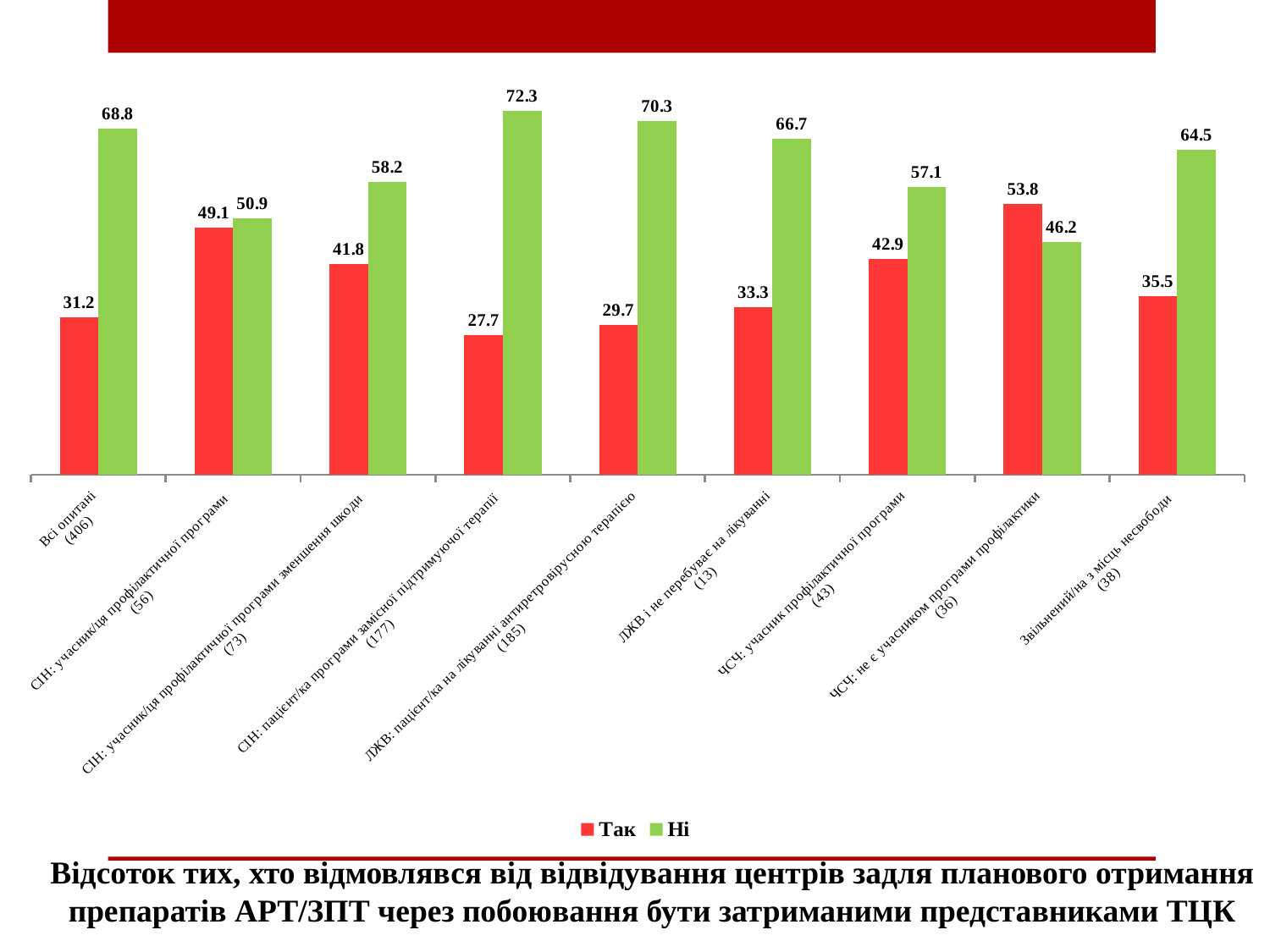
Which category has the lowest value in the "Так" series? СІН: пацієнт/ка програми замісної підтримуючої терапії (177) What is the "Ні" value for "ЛЖВ і не перебуває на лікуванні (13)"? 66.7 For "ЧСЧ: не є учасником програми профілактики (36)", which is larger, the "Так" value or the "Ні" value? Так What is the value of the "Так" series for "ЧСЧ: не є учасником програми профілактики (36)"? 53.8 What is the value of the "Так" series for "Всі опитані (406)"? 31.2 How many categories are shown on the x axis? 9 What is the difference between the "Ні" and "Так" values for "Всі опитані (406)"? 37.6 What kind of chart is shown on the slide? Bar chart What is the value of the "Ні" series for "Звільнений/на з місць несвободи (38)"? 64.5 Which category has the highest value in the "Ні" series? СІН: пацієнт/ка програми замісної підтримуючої терапії (177) Which colour represents the "Так" series in the legend? Red How many series does the legend list? 2